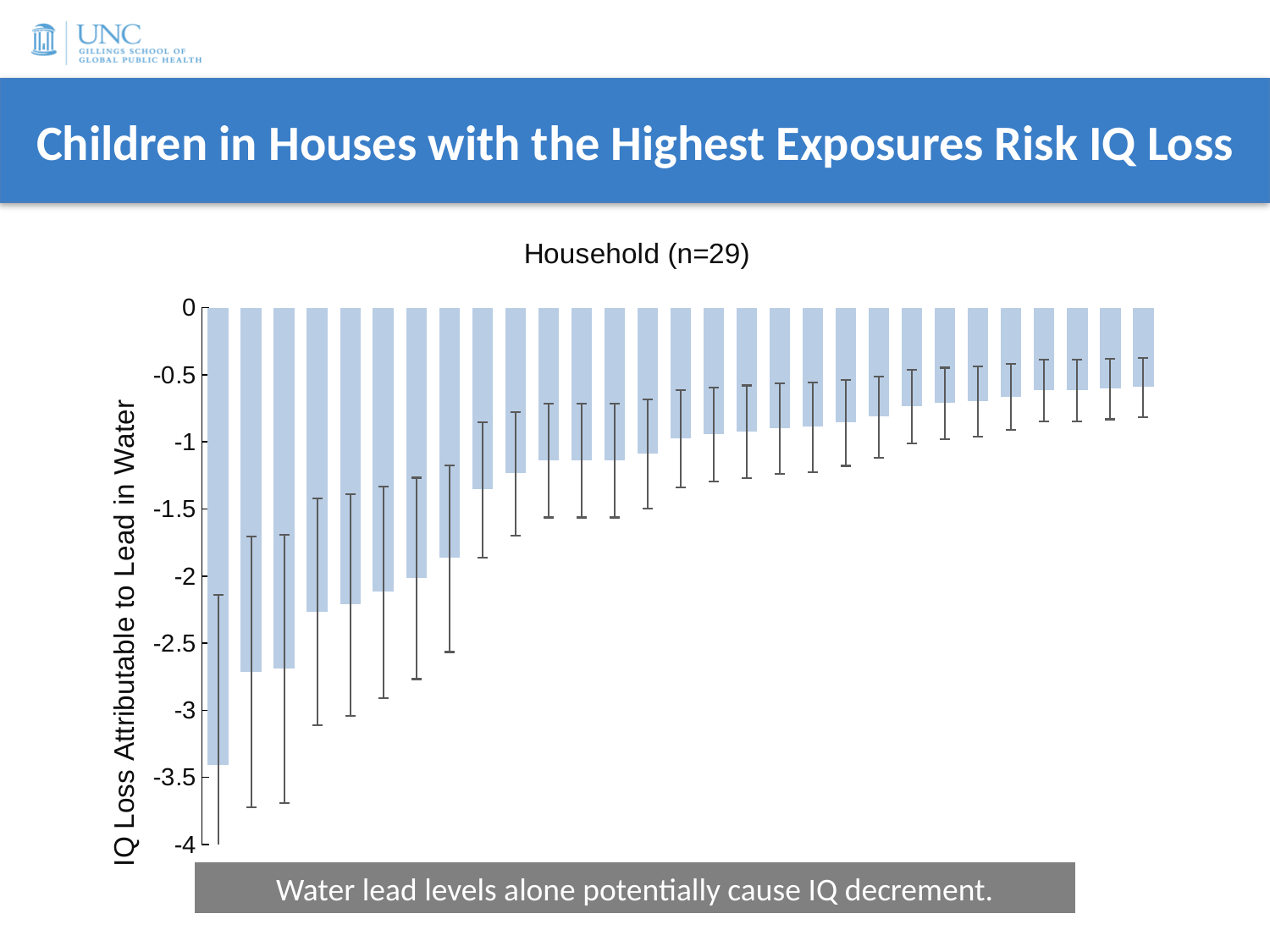
Which bar shows the smallest IQ loss (the value closest to zero)? the rightmost bar How many household bars are plotted in the chart? 29 Which has the larger IQ loss (more negative value), the leftmost bar or the rightmost bar? the leftmost bar Which bar shows the largest IQ loss (the most negative value)? the leftmost bar What kind of chart is shown on the slide? bar chart Is the value for the rightmost bar greater or less than -1? greater Is the value for the leftmost bar greater or less than -3? less What is the label on the vertical axis of the chart? IQ Loss Attributable to Lead in Water Do the bar values rise or fall (move toward zero or away from zero) from left to right along the x axis? rise toward zero What is the lowest value shown on the vertical axis of the chart? -4 What is the title of the chart? Household (n=29) Is the value for the second bar from the left greater or less than -2.5? less